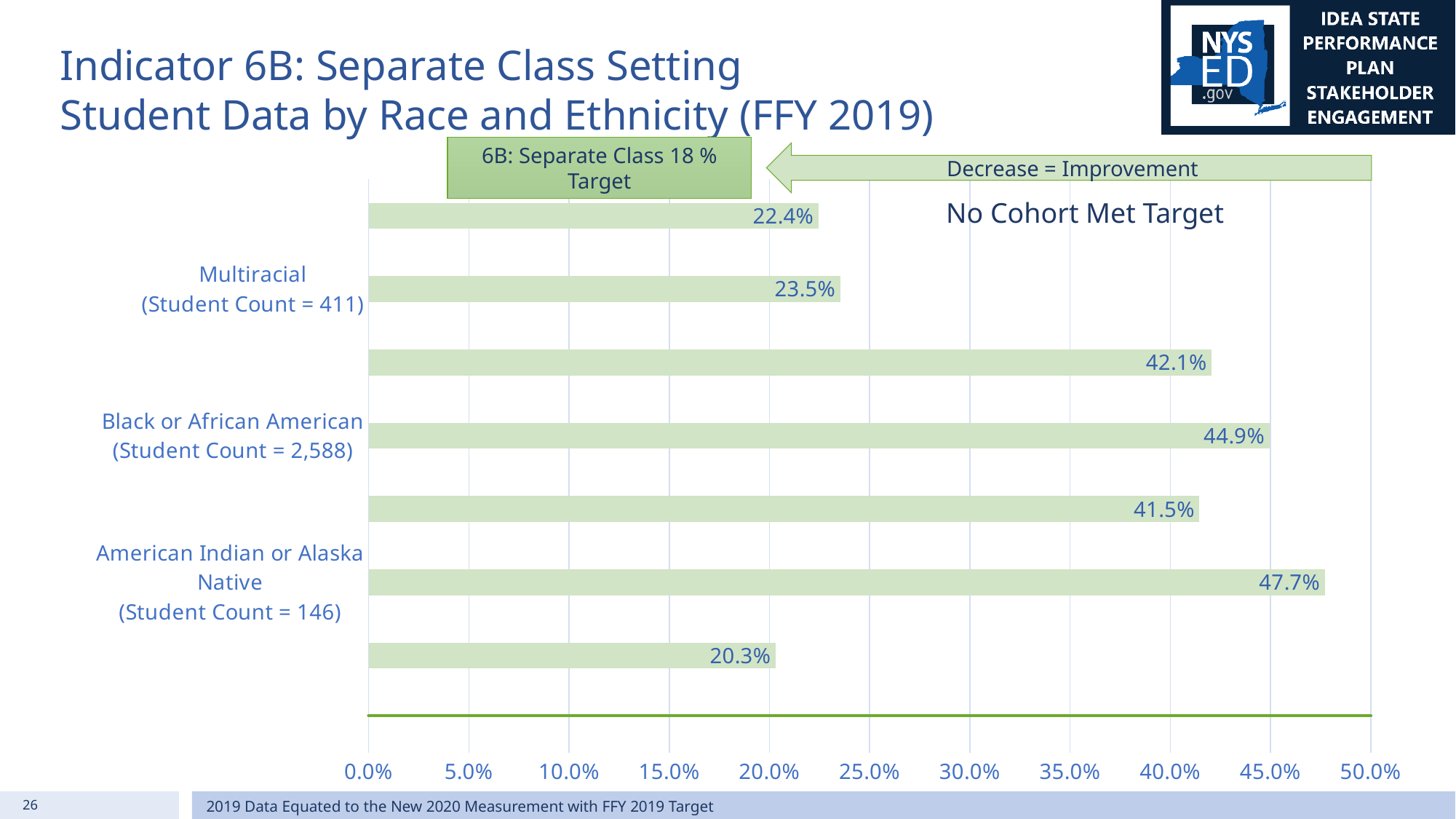
What is the value for American Indian or Alaska Native (Student Count = 146)? 47.7% What is the value for Black or African American (Student Count = 2,588)? 44.9% What kind of chart is shown on the slide? bar chart What is the value for Multiracial (Student Count = 411)? 23.5% Which is larger, the value for Multiracial or the value for Black or African American? Black or African American What is the difference between the values for Black or African American and Multiracial? 21.4 percentage points What is the difference between the values for American Indian or Alaska Native and Black or African American? 2.8 percentage points How many bars are plotted in the chart? 7 What target percentage is stated in the box above the chart for 6B: Separate Class? 18 % Is the value for Multiracial greater or less than 25.0%? less Which labelled category has the highest value? American Indian or Alaska Native What is the lowest value shown on any bar in the chart? 20.3%